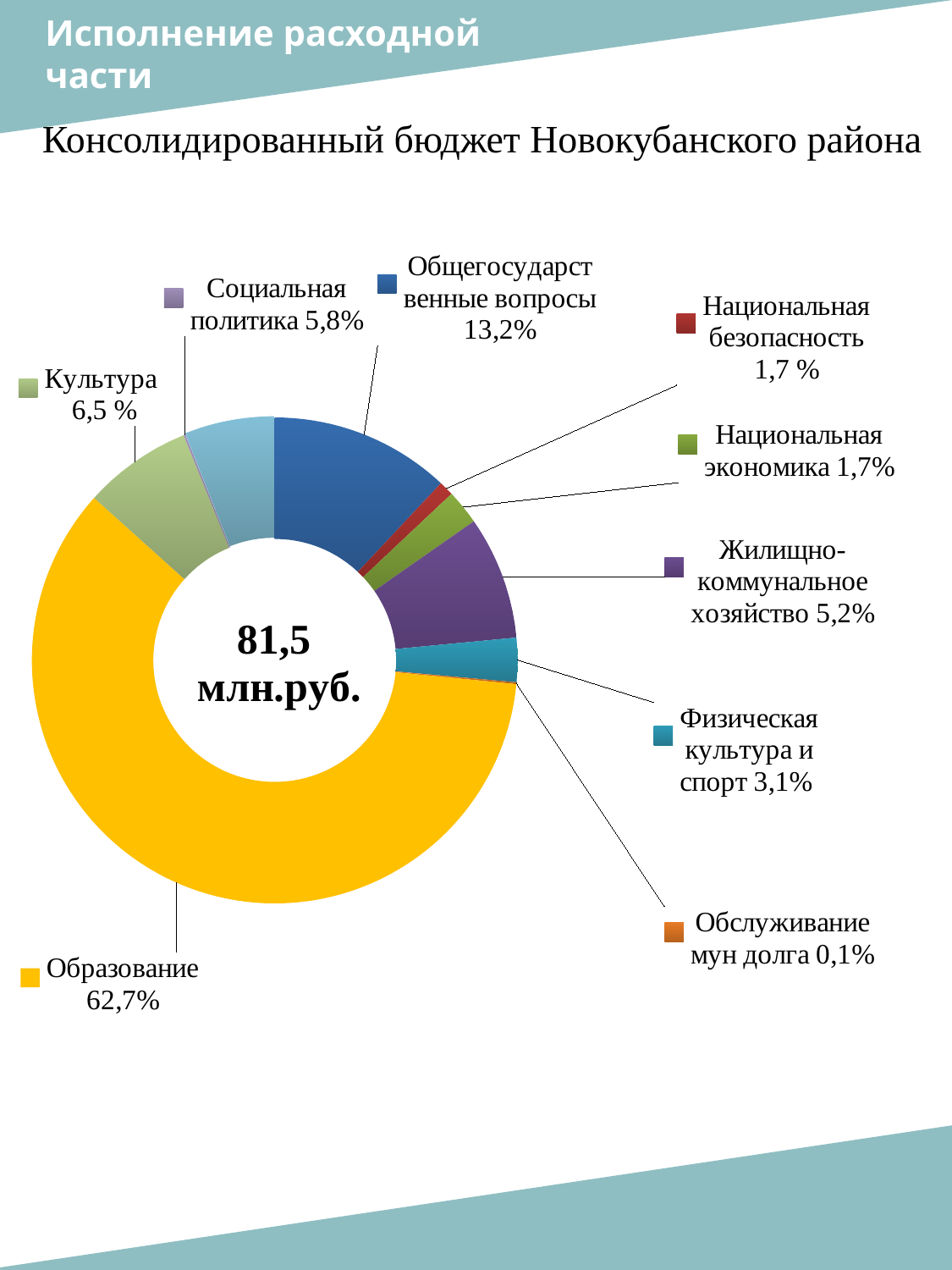
What percentage is shown for Общегосударственные вопросы? 13,2% How many categories are shown in the chart? 9 What is the difference in percentage points between Культура and Социальная политика? 0,7 What percentage is shown for Физическая культура и спорт? 3,1% Which category has the largest share of the chart? Образование What share of the budget goes to Образование? 62,7% What share is labelled for Жилищно-коммунальное хозяйство? 5,2% Which category has the smallest share of the chart? Обслуживание мун долга What total amount is printed in the centre of the chart? 81,5 млн.руб. Which has the larger share, Культура or Социальная политика? Культура By how many percentage points does Образование exceed Общегосударственные вопросы? 49,5 What kind of chart is shown on the slide? doughnut chart